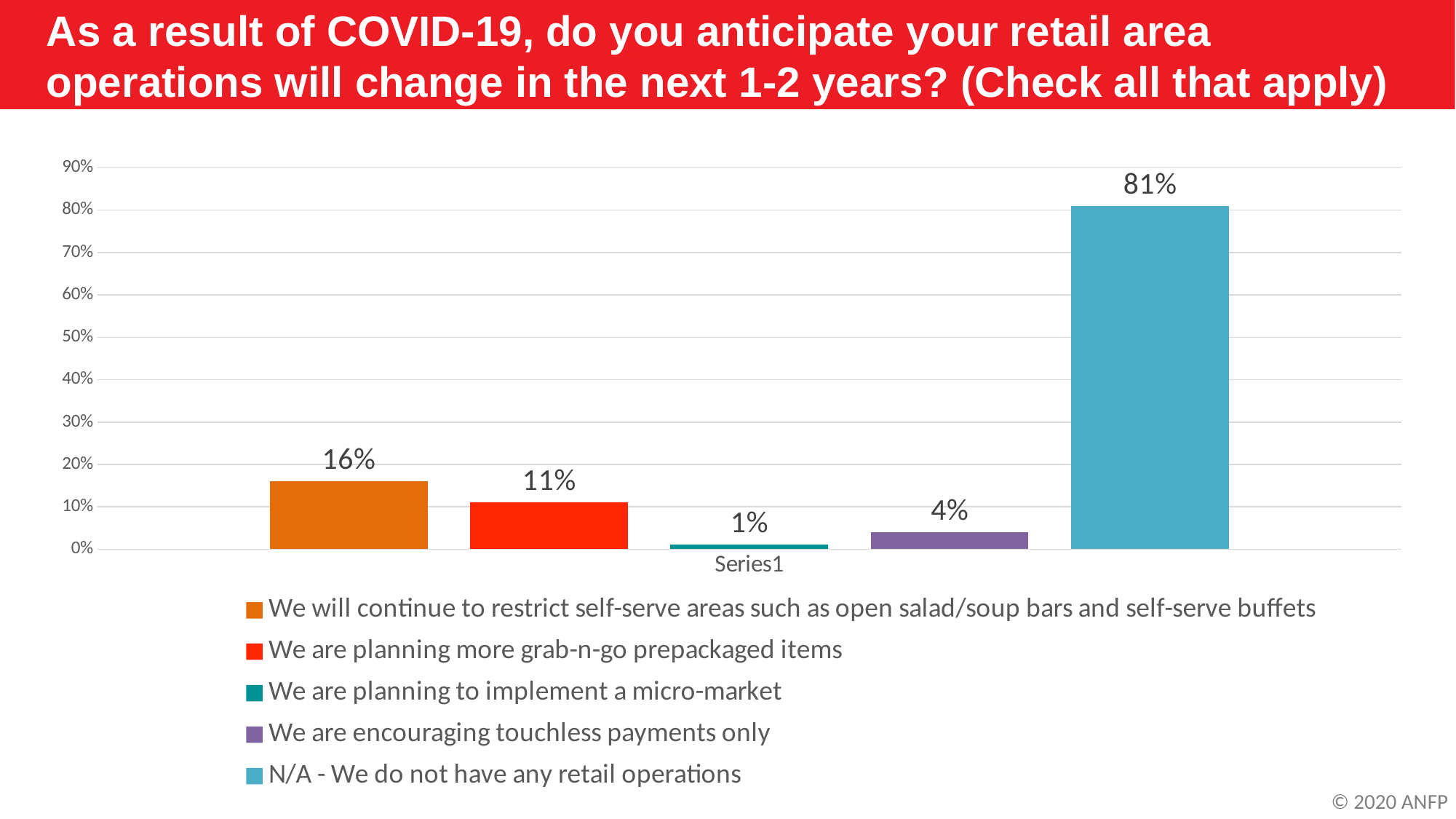
Which response has the highest percentage? N/A - We do not have any retail operations How many series does the legend list? 5 What colour is the bar for N/A - We do not have any retail operations? Light blue What kind of chart is shown on the slide? Bar chart What percentage of respondents said they will continue to restrict self-serve areas such as open salad/soup bars and self-serve buffets? 16% Which response has the lowest percentage? We are planning to implement a micro-market What percentage of respondents are encouraging touchless payments only? 4% Which is larger: the percentage planning more grab-n-go prepackaged items or the percentage encouraging touchless payments only? We are planning more grab-n-go prepackaged items What percentage of respondents are planning to implement a micro-market? 1% What percentage of respondents answered N/A - We do not have any retail operations? 81% What percentage of respondents are planning more grab-n-go prepackaged items? 11% What is the difference in percentage points between the N/A response and the response about restricting self-serve areas? 65